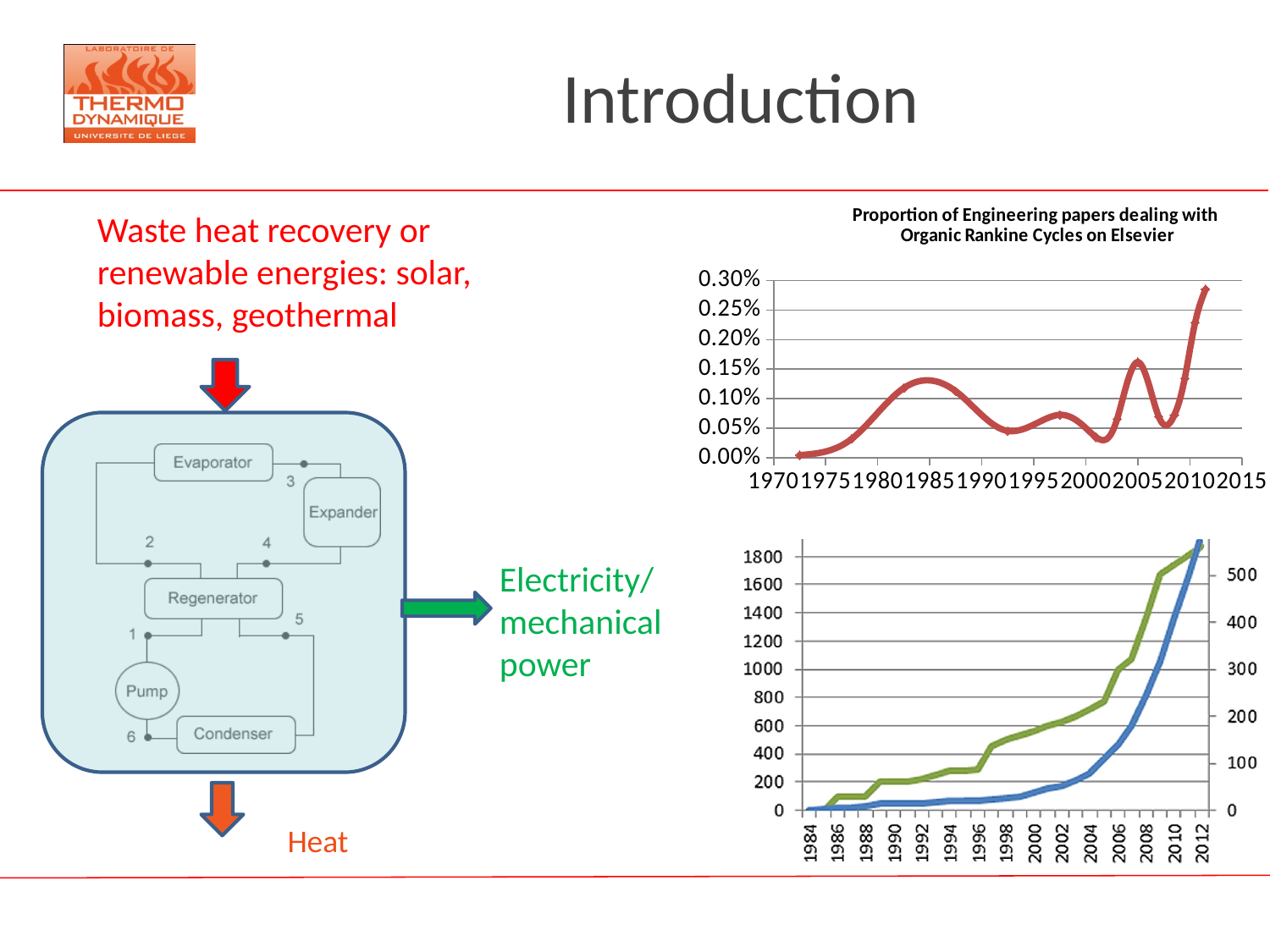
In the top-right chart on Organic Rankine Cycle papers, is the value around 1985 greater or less than 0.15%? less How many series are plotted in the bottom-right chart with years 1984 to 2012? 2 In the top-right chart on Organic Rankine Cycle papers, is the value around 1975 greater or less than 0.05%? less In the top-right chart on Organic Rankine Cycle papers, how many year labels are shown on the x axis? 10 What kind of chart is the bottom-right chart with years 1984 to 2012 on the x axis? line chart In the top-right chart on Organic Rankine Cycle papers, what is the highest value shown on the y axis? 0.30% In the top-right chart on Organic Rankine Cycle papers, is the value at the final point (around 2012) greater or less than 0.25%? greater In the bottom-right chart with years 1984 to 2012, do the values rise or fall from left to right? rise What is the title of the top-right chart? Proportion of Engineering papers dealing with Organic Rankine Cycles on Elsevier What kind of chart is the top-right chart titled 'Proportion of Engineering papers dealing with Organic Rankine Cycles on Elsevier'? line chart